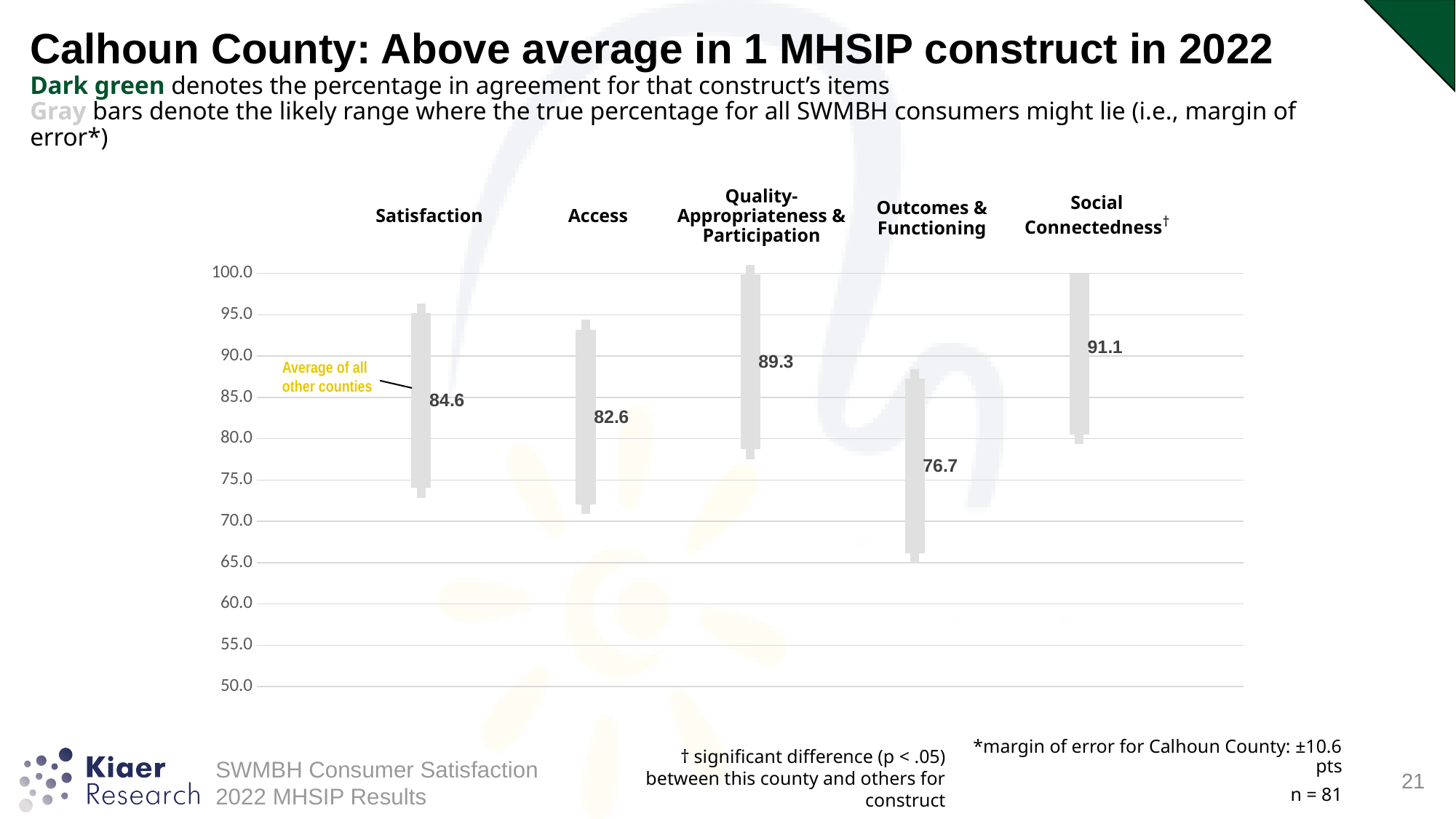
Which construct has the lowest labeled value? Outcomes & Functioning What value is labeled for Outcomes & Functioning? 76.7 How many constructs are shown on the chart? 5 What value is labeled for Quality-Appropriateness & Participation? 89.3 What value is labeled for Social Connectedness? 91.1 Which has a larger labeled value, Satisfaction or Access? Satisfaction Which construct is marked with a dagger (†) indicating a significant difference? Social Connectedness What is the difference between the labeled values for Social Connectedness and Outcomes & Functioning? 14.4 Which construct has the highest labeled value? Social Connectedness What value is labeled for Access? 82.6 Is the labeled value for Outcomes & Functioning greater or less than 80.0? less What value is labeled for Satisfaction? 84.6